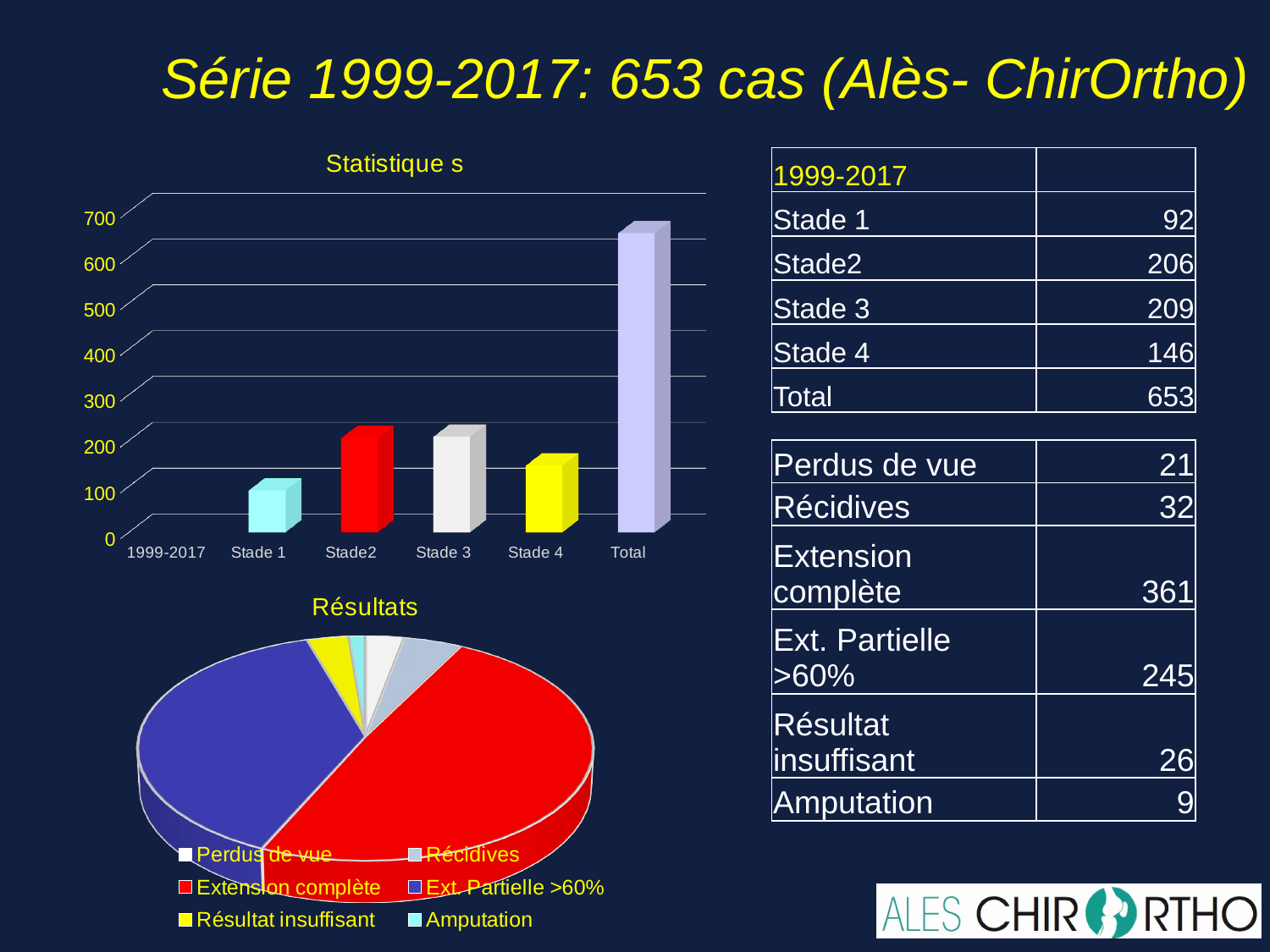
In the 'Statistique s' bar chart, what is the difference between the Total value and the Stade 3 value, using the values in the table? 444 In the 'Statistique s' bar chart, which is larger, the bar for Stade 4 or the bar for Stade 1? Stade 4 In the 'Statistique s' bar chart, which of the plotted stages has the shortest bar? Stade 1 In the 'Statistique s' bar chart, is the value for Stade 3 greater or less than 100? greater What kind of chart is the 'Résultats' chart? pie chart In the 'Statistique s' bar chart, which category has the tallest bar? Total In the 'Résultats' pie chart, which category has the largest slice? Extension complète In the 'Statistique s' bar chart, what is the value for Stade 3 as given in the table on the slide? 209 In the 'Statistique s' bar chart, is the value for Total greater or less than 600? greater How many entries does the legend of the 'Résultats' pie chart list? 6 In the 'Statistique s' bar chart, is the value for Stade 4 greater or less than 100? greater What kind of chart is the 'Statistique s' chart? bar chart